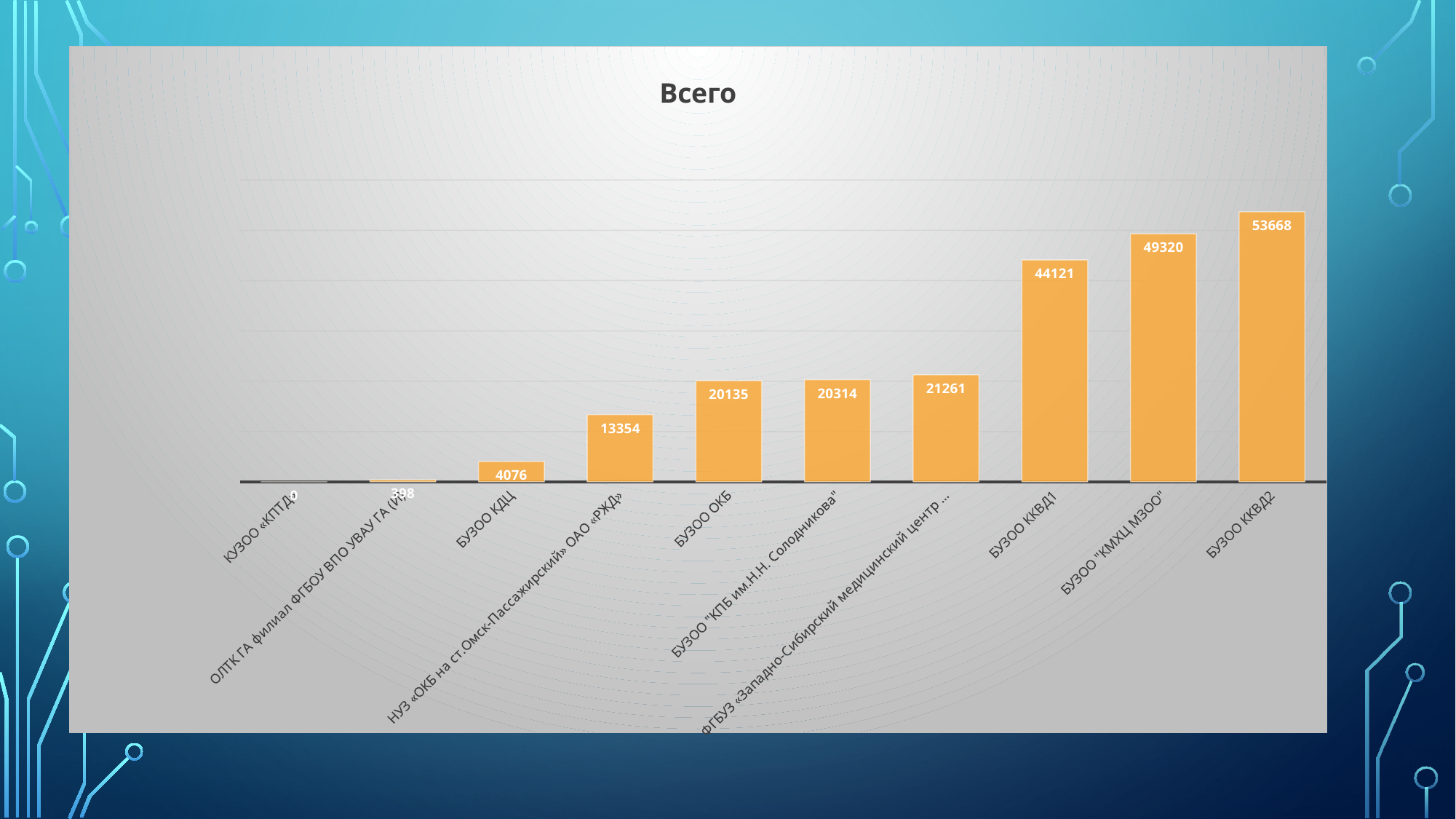
What is the title of the chart? Всего What is the value for БУЗОО ККВД1? 44121 Which category has the highest value? БУЗОО ККВД2 What kind of chart is shown on the slide? bar chart What is the value for БУЗОО ККВД2? 53668 What is the value for БУЗОО КДЦ? 4076 What is the difference between the values for БУЗОО ККВД2 and БУЗОО "КМХЦ МЗОО"? 4348 How many categories are shown in the chart? 10 What is the value for БУЗОО ОКБ? 20135 Which category has the lowest value? КУЗОО «КПТД» Which is larger, the value for БУЗОО "КМХЦ МЗОО" or the value for БУЗОО ККВД1? БУЗОО "КМХЦ МЗОО" What is the difference between the values for БУЗОО ККВД1 and БУЗОО КДЦ? 40045